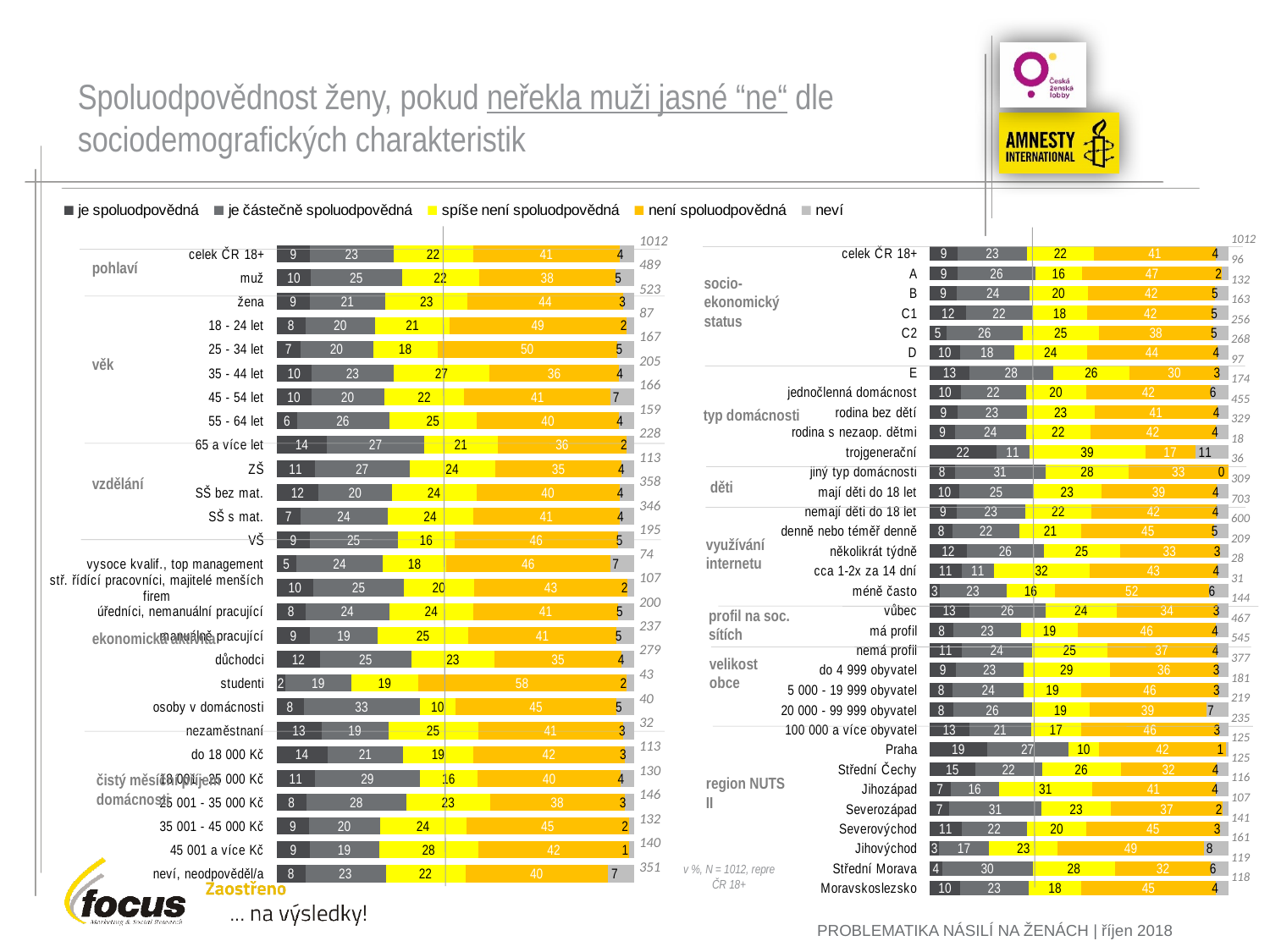
In the left chart, what is the total of the stacked bar for 'studenti'? 100 In the right chart, what is the value of 'neví' for 'trojgenerační'? 11 In the left chart, what is the difference between the 'není spoluodpovědná' values for 'žena' and 'muž'? 6 In the right chart, what is the value of 'není spoluodpovědná' for socio-economic status 'E'? 30 In the right chart, what is the value of 'je spoluodpovědná' for 'Praha'? 19 What is the first series listed in the legend? je spoluodpovědná In the left chart, what is the value of 'je částečně spoluodpovědná' for 'muž'? 25 How many series does the legend list? 5 In the left chart, which category has the highest value for 'není spoluodpovědná'? studenti In the left chart, what is the value of 'není spoluodpovědná' for 'studenti'? 58 What kind of chart is shown on the slide? Stacked bar chart In the right chart, which is larger: the 'není spoluodpovědná' value for 'A' or for 'E'? A